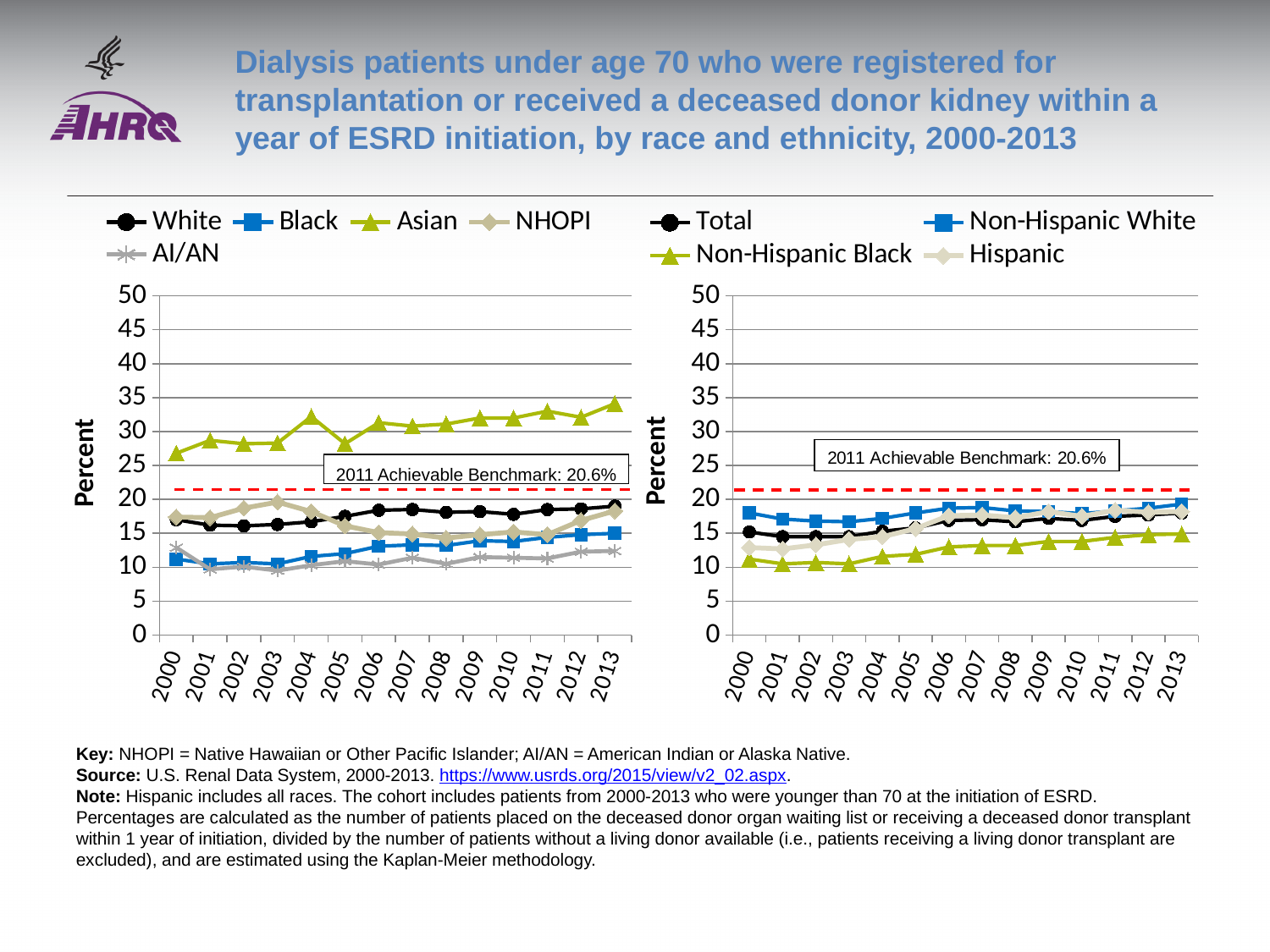
How many years are plotted along the x axis of the right chart? 14 In the right chart, is the value for Non-Hispanic Black in 2000 greater or less than 15? less How many series does the legend of the left chart list? 5 In the left chart, which is larger in 2013, the value for Asian or the value for Black? Asian In the right chart, do the values for Non-Hispanic Black generally rise or fall from 2000 to 2013? rise In the left chart, is the value for Black in 2000 greater or less than 15? less What is the 2011 Achievable Benchmark value shown on the charts? 20.6% In the right chart, which series has the lowest values across the years shown? Non-Hispanic Black In the left chart, is the value for Asian in 2013 greater or less than 30? greater How many series does the legend of the right chart list? 4 In the left chart, which series has the highest values across the years shown? Asian What type of chart is the left chart on the slide? line chart